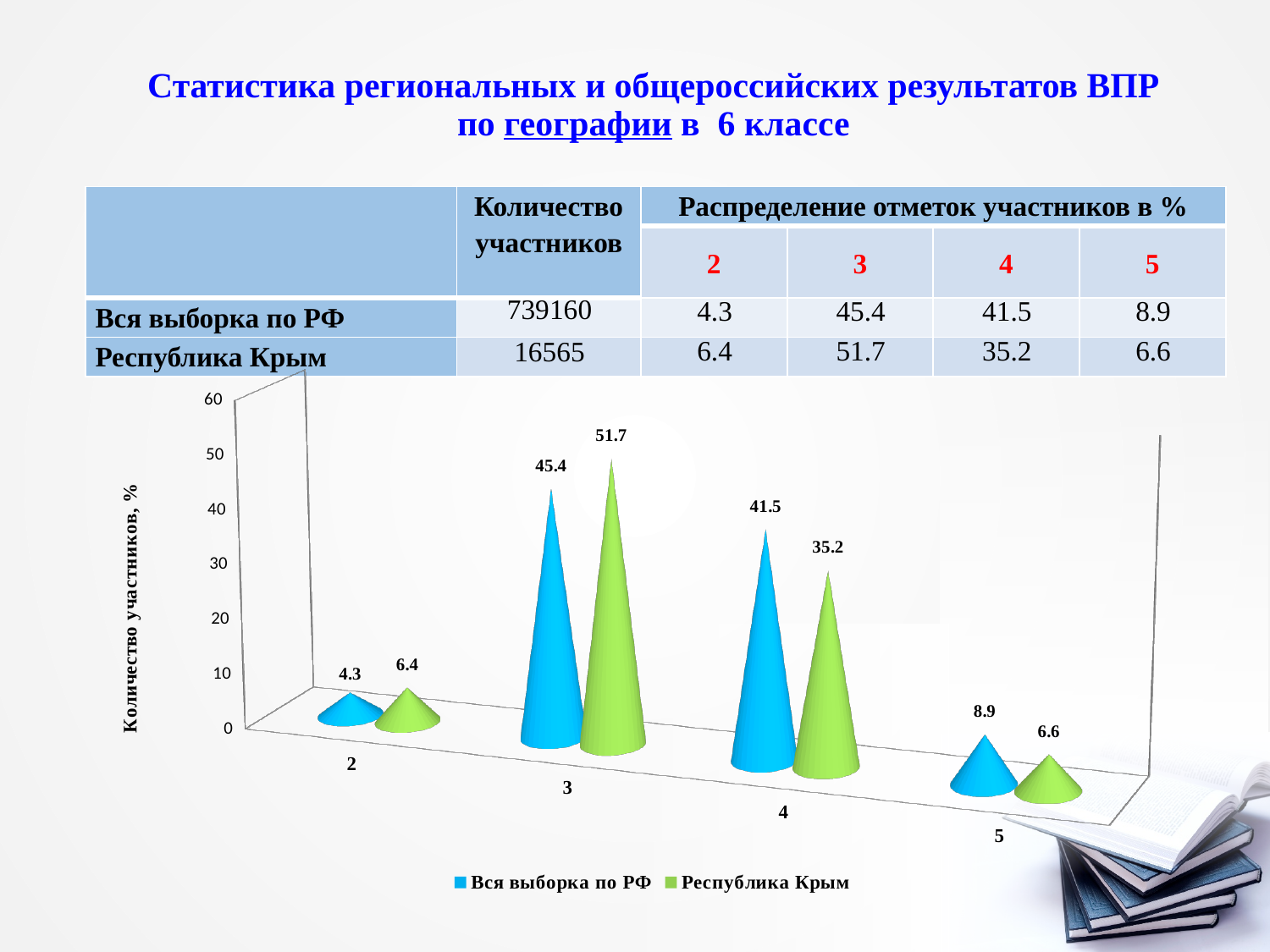
How many marks (categories) are shown on the x axis of the chart? 4 What is the difference between Республика Крым and Вся выборка по РФ at mark 3? 6.3 What is the value for Вся выборка по РФ at mark 2? 4.3 Which mark has the highest value for Республика Крым? 3 Which mark has the lowest value for Вся выборка по РФ? 2 What is the value for Республика Крым at mark 5? 6.6 What is the label of the vertical axis of the chart? Количество участников, % What kind of chart is shown on the slide? bar chart What is the value for Республика Крым at mark 3? 51.7 At mark 4, which series has the larger value, Вся выборка по РФ or Республика Крым? Вся выборка по РФ How many series does the chart legend list? 2 What is the value for Вся выборка по РФ at mark 4? 41.5